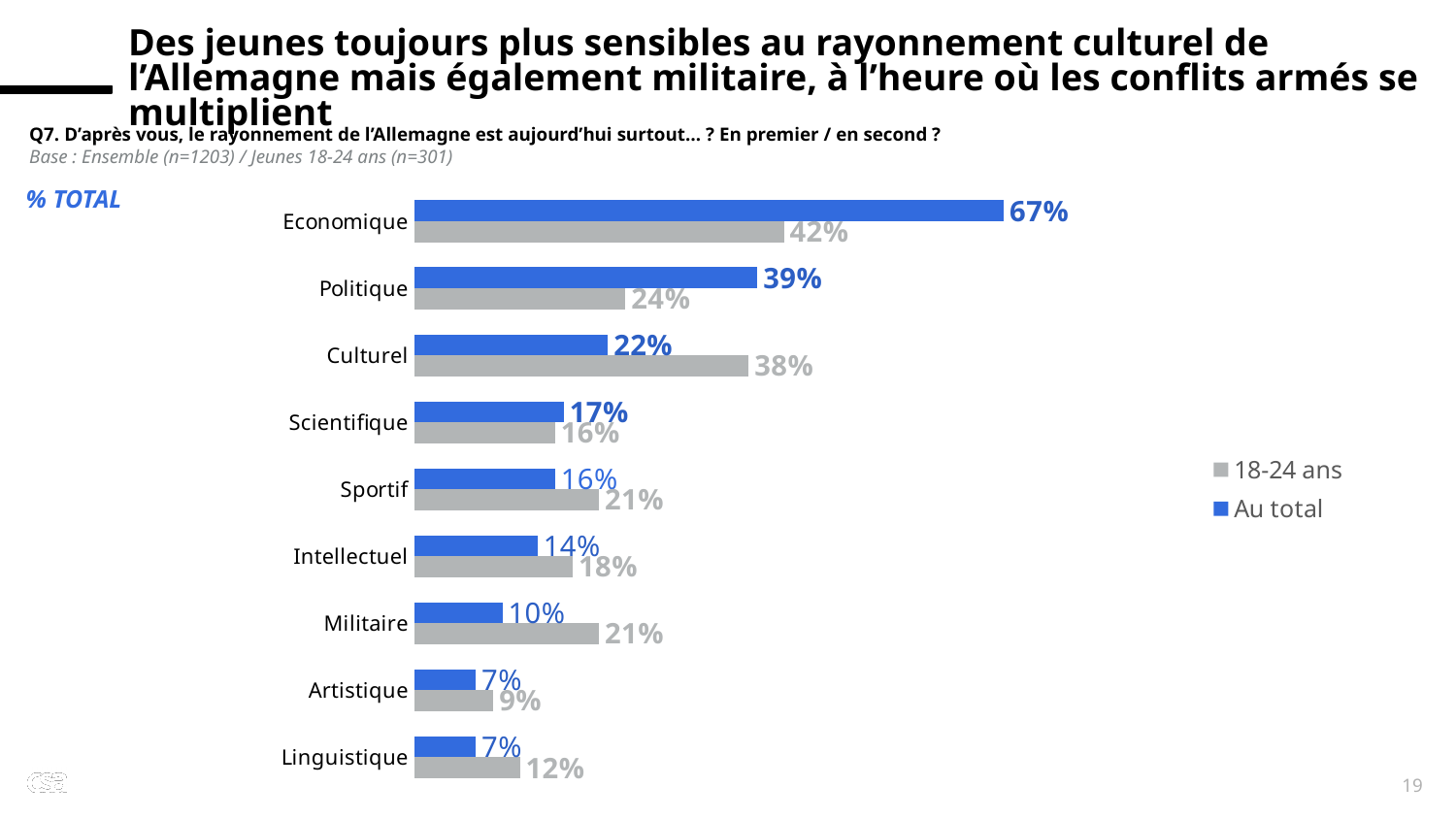
What is the value for Culturel in the 18-24 ans series? 38% What is the value for Economique in the Au total series? 67% What is the difference between the 18-24 ans and Au total values for Militaire? 11% What kind of chart is shown on the slide? Bar chart Which colour represents the 18-24 ans series in the legend? Grey Which is larger for Culturel: the Au total value or the 18-24 ans value? 18-24 ans What is the value for Militaire in the 18-24 ans series? 21% Which category has the highest value in the Au total series? Economique How many categories are shown on the chart? 9 Which category has the lowest value in the 18-24 ans series? Artistique How many series does the legend list? 2 What is the difference between the Au total and 18-24 ans values for Economique? 25%